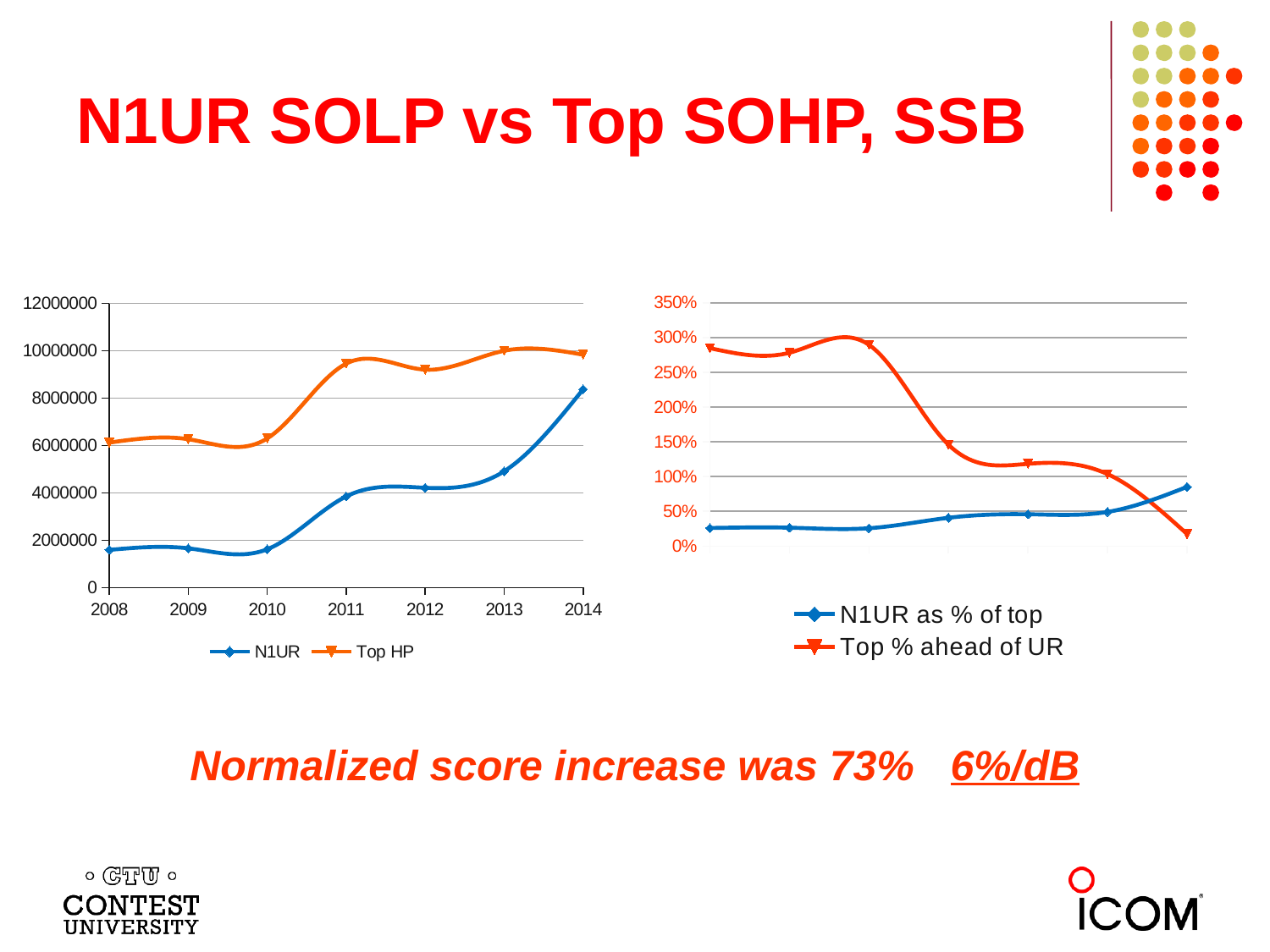
In the right chart, is the first value of the Top % ahead of UR series greater or less than 250%? greater How many series does the legend of the right chart list? 2 In the left chart, is the N1UR value for 2014 greater or less than 8000000? greater In the right chart, does the Top % ahead of UR series generally rise or fall along the x axis? fall In the left chart, is the Top HP value for 2013 greater or less than 8000000? greater What kind of chart is the left chart? line chart How many years are shown on the x axis of the left chart? 7 In the left chart, in which year is the N1UR series highest? 2014 In the left chart, does the N1UR series generally rise or fall from 2008 to 2014? rise In the left chart, which series has the larger value in 2011, N1UR or Top HP? Top HP How many series does the legend of the left chart list? 2